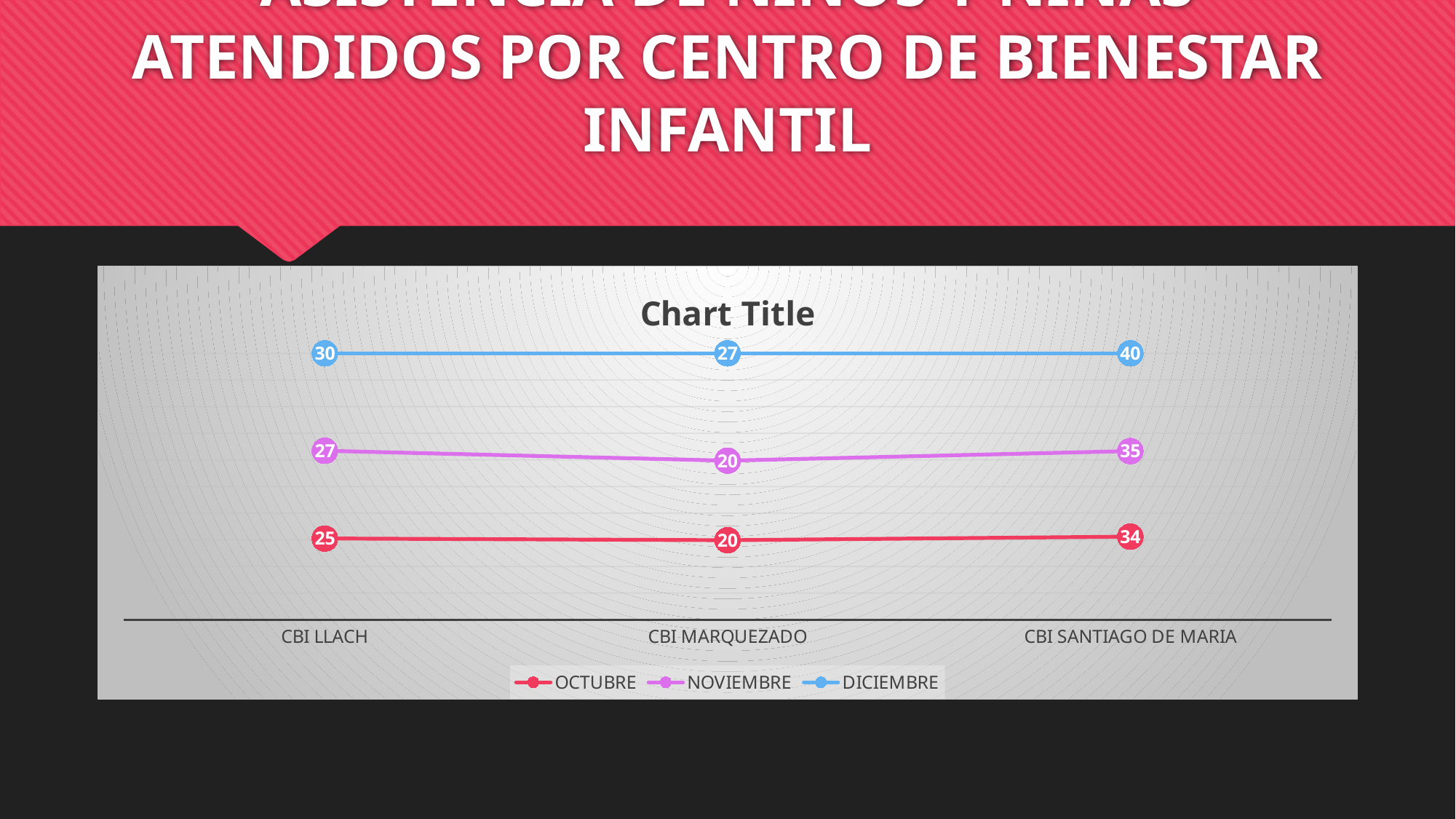
What is the OCTUBRE value for CBI LLACH? 25 How many series does the legend list? 3 What is the difference between the DICIEMBRE and OCTUBRE values for CBI LLACH? 5 What is the NOVIEMBRE value for CBI MARQUEZADO? 20 Which is larger for CBI MARQUEZADO, the DICIEMBRE value or the OCTUBRE value? DICIEMBRE What is the title printed above the chart? Chart Title What is the DICIEMBRE value for CBI SANTIAGO DE MARIA? 40 Which centre has the highest DICIEMBRE value? CBI SANTIAGO DE MARIA What type of chart is shown on the slide? line chart What is the difference between the NOVIEMBRE values for CBI SANTIAGO DE MARIA and CBI MARQUEZADO? 15 How many centres are shown on the x axis? 3 Which centre has the lowest OCTUBRE value? CBI MARQUEZADO